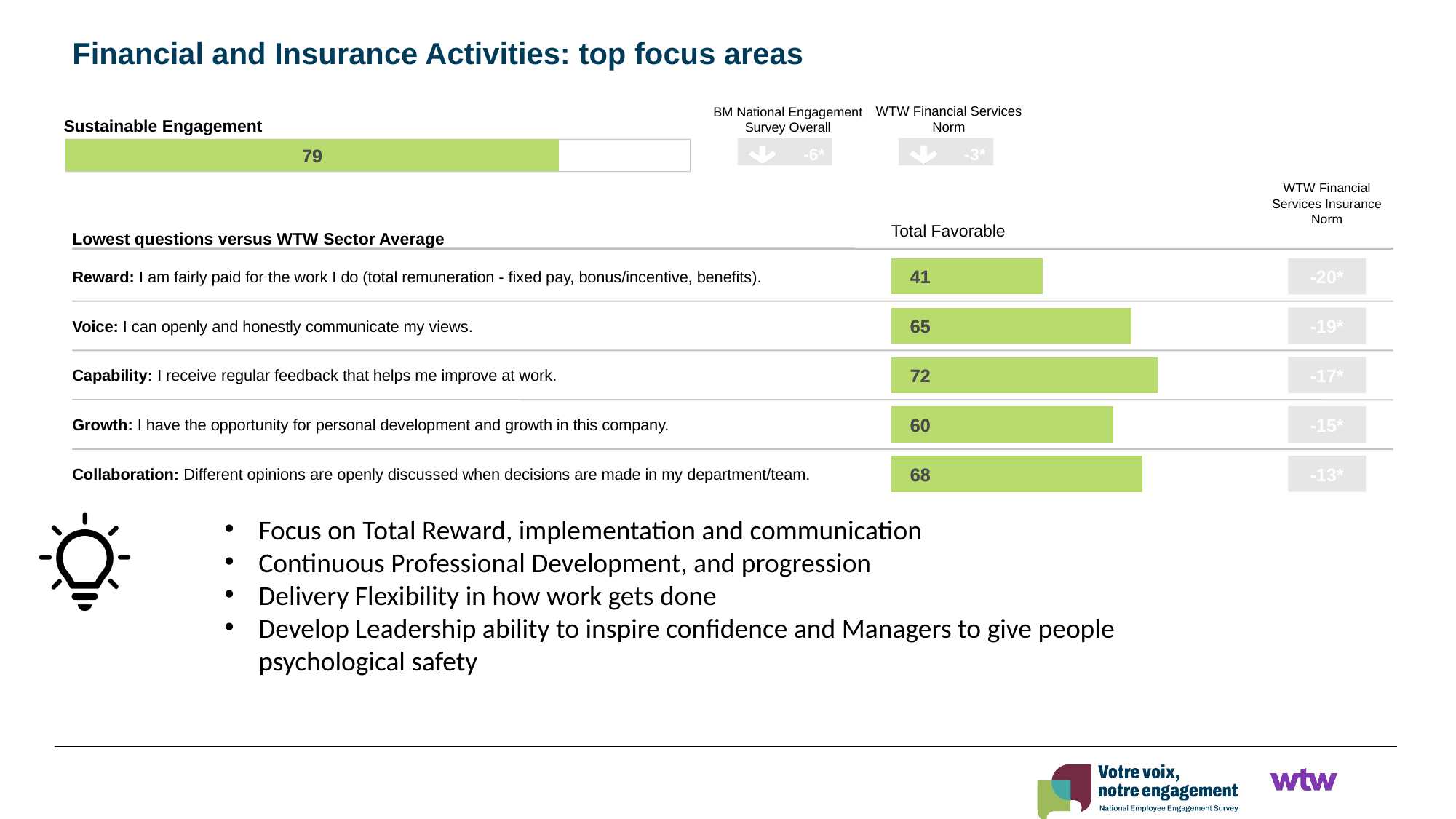
In the Sustainable Engagement bar at the top of the slide, what value is shown? 79 In the Lowest questions versus WTW Sector Average chart, which question has the highest Total Favorable value? Capability How many questions are plotted in the Lowest questions versus WTW Sector Average chart? 5 In the Lowest questions versus WTW Sector Average chart, what is the Total Favorable value for Reward? 41 In the Lowest questions versus WTW Sector Average chart, what is the difference between the Total Favorable values for Capability and Reward? 31 In the Lowest questions versus WTW Sector Average chart, what is the Total Favorable value for Capability? 72 In the Sustainable Engagement section, what difference is shown versus the WTW Financial Services Norm? -3* What kind of chart is used to show the Total Favorable values in the Lowest questions versus WTW Sector Average section? Bar chart In the Lowest questions versus WTW Sector Average chart, what is the Total Favorable value for Growth? 60 In the Lowest questions versus WTW Sector Average chart, which question has the lowest Total Favorable value? Reward In the Lowest questions versus WTW Sector Average chart, which has a higher Total Favorable value, Voice or Collaboration? Collaboration In the Lowest questions versus WTW Sector Average chart, what is the WTW Financial Services Insurance Norm difference shown for Reward? -20*